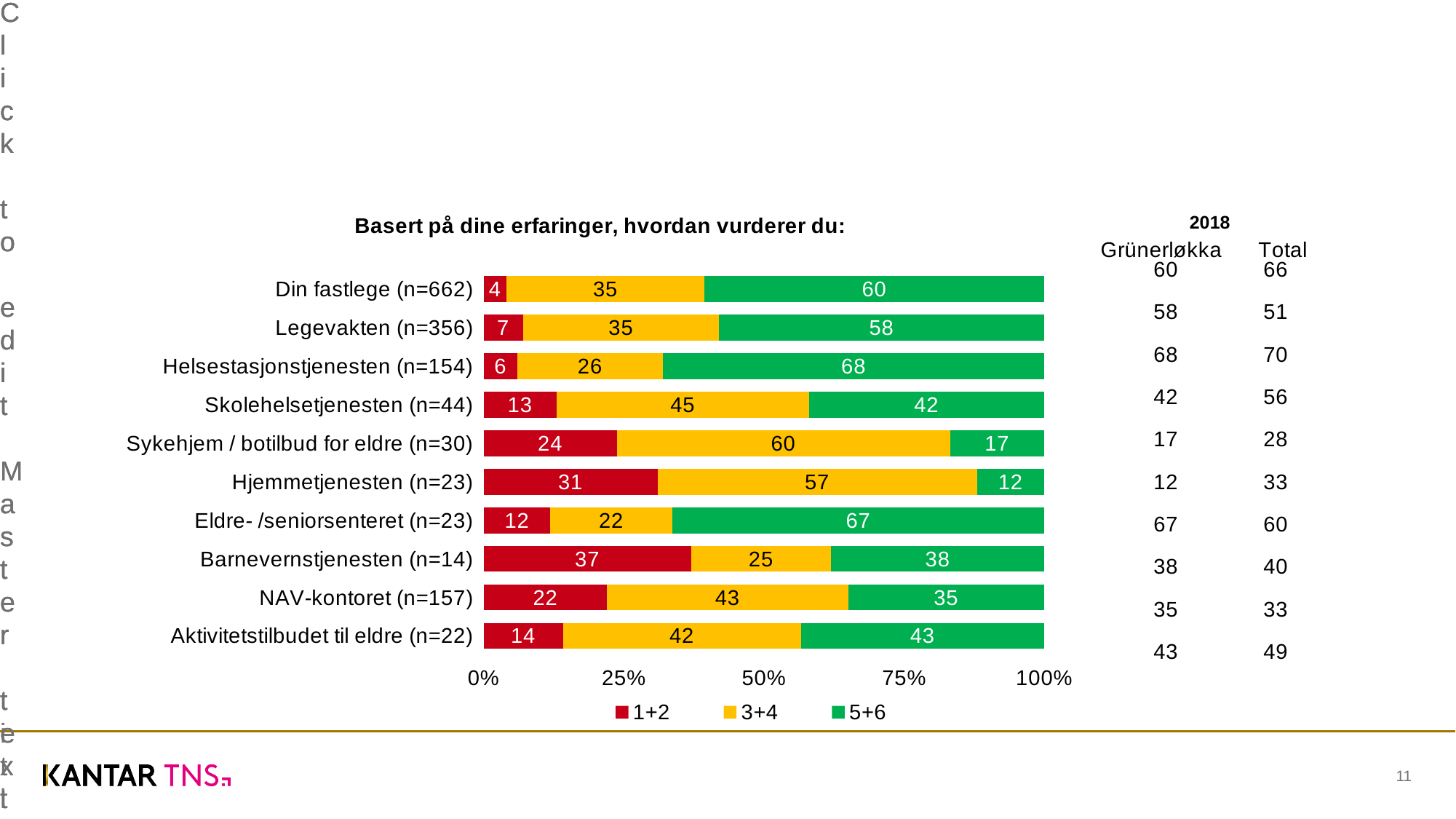
How many categories are shown in the chart? 10 How many series does the legend list? 3 Which category has the lowest value in the 1+2 series? Din fastlege (n=662) What kind of chart is shown on the slide? Stacked bar chart Which category has the lowest value in the 5+6 series? Hjemmetjenesten (n=23) What is the value of the 5+6 series for Din fastlege (n=662)? 60 Which category has the highest value in the 5+6 series? Helsestasjonstjenesten (n=154) What is the value of the 3+4 series for Sykehjem / botilbud for eldre (n=30)? 60 What is the value of the 1+2 series for Barnevernstjenesten (n=14)? 37 Which is larger: the 1+2 value for Hjemmetjenesten (n=23) or the 1+2 value for NAV-kontoret (n=157)? Hjemmetjenesten (n=23) What is the title of the chart? Basert på dine erfaringer, hvordan vurderer du: What is the difference between the 5+6 values for Helsestasjonstjenesten (n=154) and Hjemmetjenesten (n=23)? 56